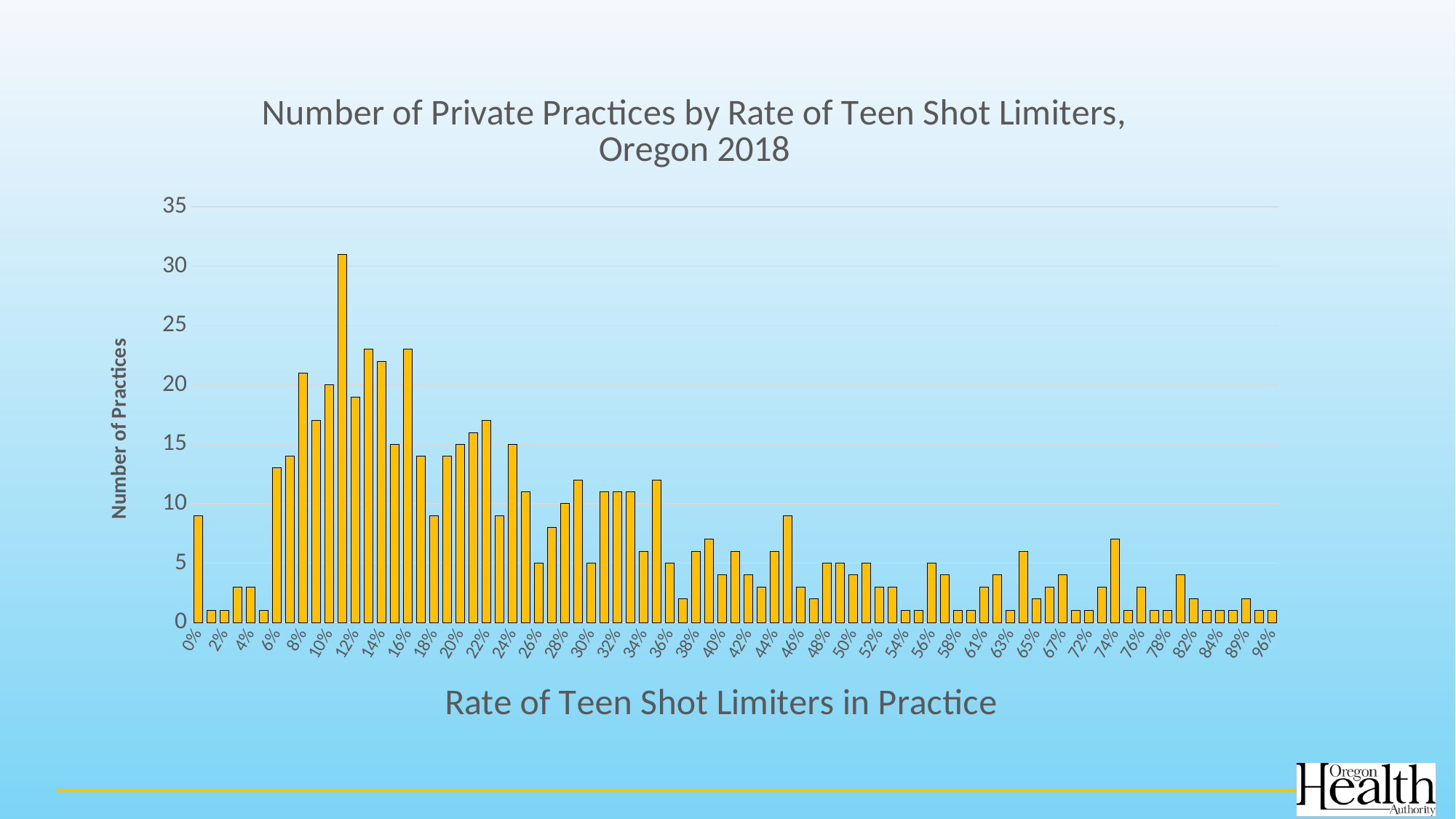
Is the number of practices at the 0% rate greater or less than 5? greater Is the number of practices at the 96% rate greater or less than 5? less What type of chart is shown on the slide? Bar chart Moving from the 20% rate to the 96% rate, do the bar heights generally rise or fall? fall Which has more practices: the 10% rate or the 40% rate? 10% What is the label on the x axis of the chart? Rate of Teen Shot Limiters in Practice What is the title of the chart? Number of Private Practices by Rate of Teen Shot Limiters, Oregon 2018 Which has more practices: the 0% rate or the 2% rate? 0% Is the number of practices at the 6% rate greater or less than 10? greater